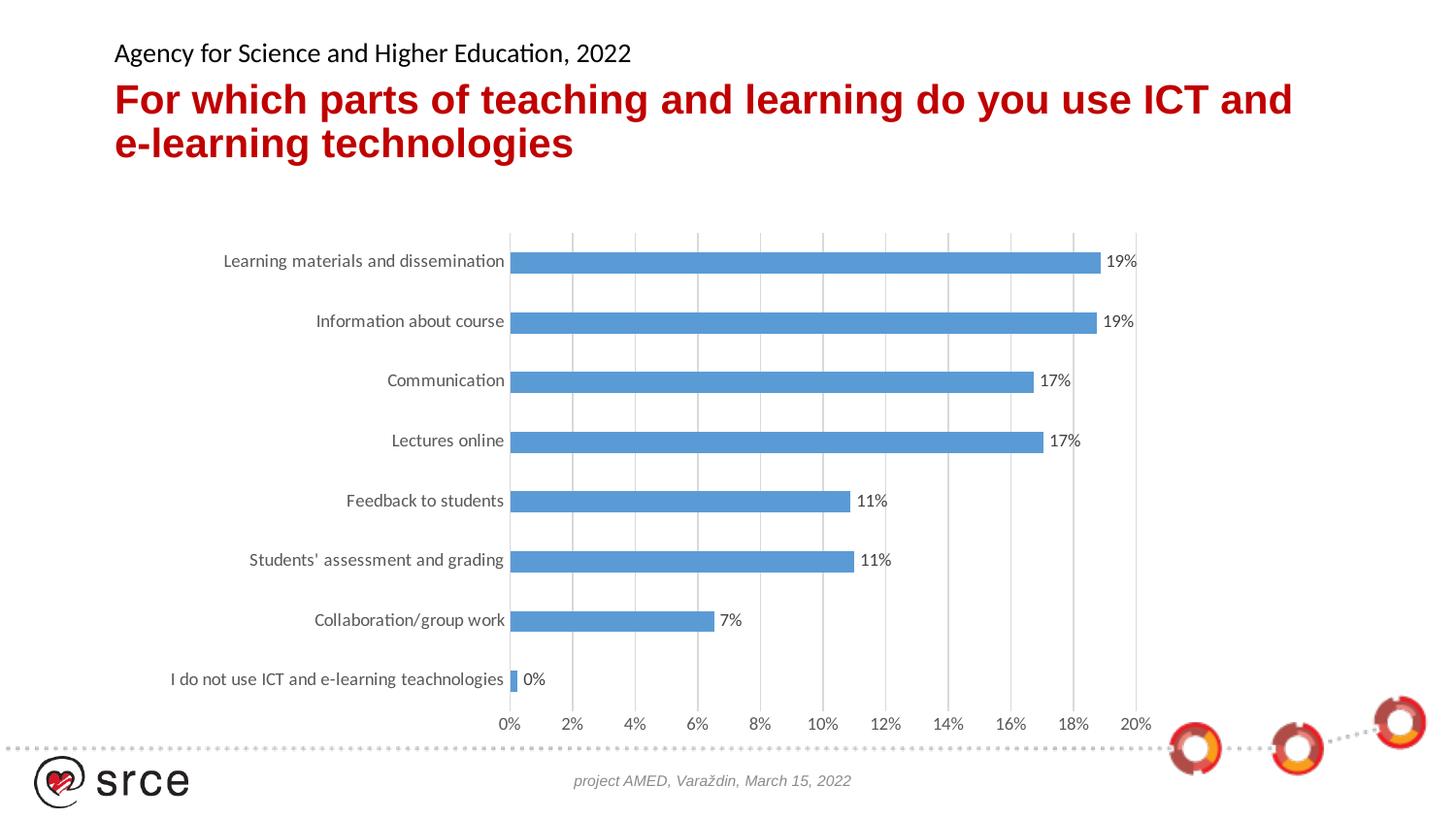
What is the title of the slide above the chart? For which parts of teaching and learning do you use ICT and e-learning technologies What is the value for Lectures online? 17% Is the value for Students' assessment and grading greater or less than 10%? greater What kind of chart is shown on the slide? bar chart What is the value for Feedback to students? 11% What is the value for Communication? 17% How many categories are shown in the chart? 8 Which is larger, the value for Communication or the value for Collaboration/group work? Communication What is the difference between the value for Learning materials and dissemination and the value for Collaboration/group work? 12 percentage points What percentage is shown for Collaboration/group work? 7% Which category has the lowest value? I do not use ICT and e-learning teachnologies What percentage is shown for Learning materials and dissemination? 19%